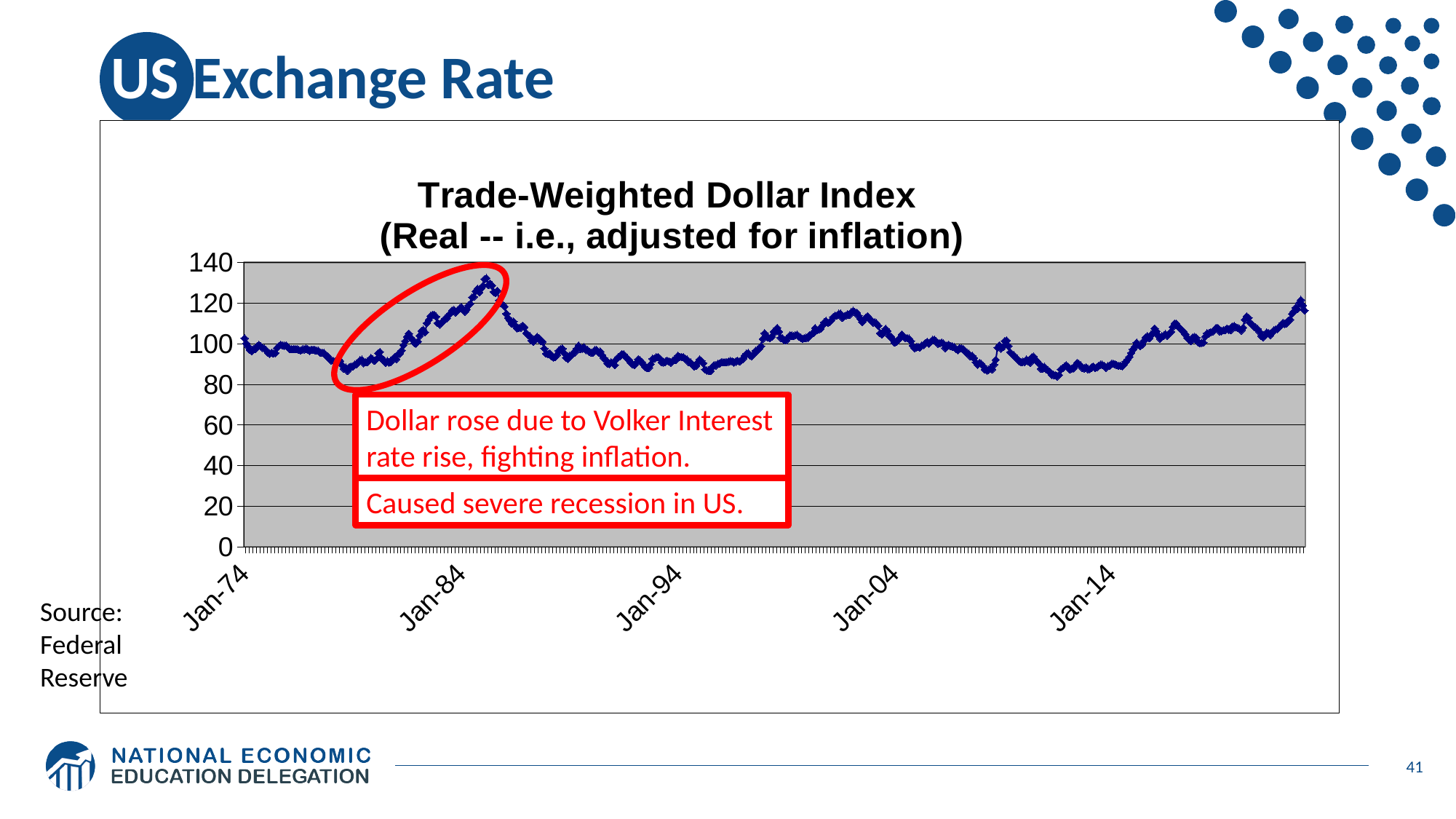
Is the peak value of the Trade-Weighted Dollar Index reached in the mid-1980s greater or less than 120? greater Does the Trade-Weighted Dollar Index rise or fall between its mid-1980s peak and Jan-94? fall Is the value of the Trade-Weighted Dollar Index at Jan-04 greater or less than 60? greater Is the value of the Trade-Weighted Dollar Index at Jan-74 greater or less than 80? greater How many date labels are shown on the x axis of the chart? 5 Which is larger: the Trade-Weighted Dollar Index at its mid-1980s peak or at Jan-14? Mid-1980s peak What is the title of the chart? Trade-Weighted Dollar Index (Real -- i.e., adjusted for inflation) What kind of chart is shown on the slide? Line chart Does the Trade-Weighted Dollar Index rise or fall from Jan-14 to the end of the series? rise What is the highest value shown on the y axis of the chart? 140